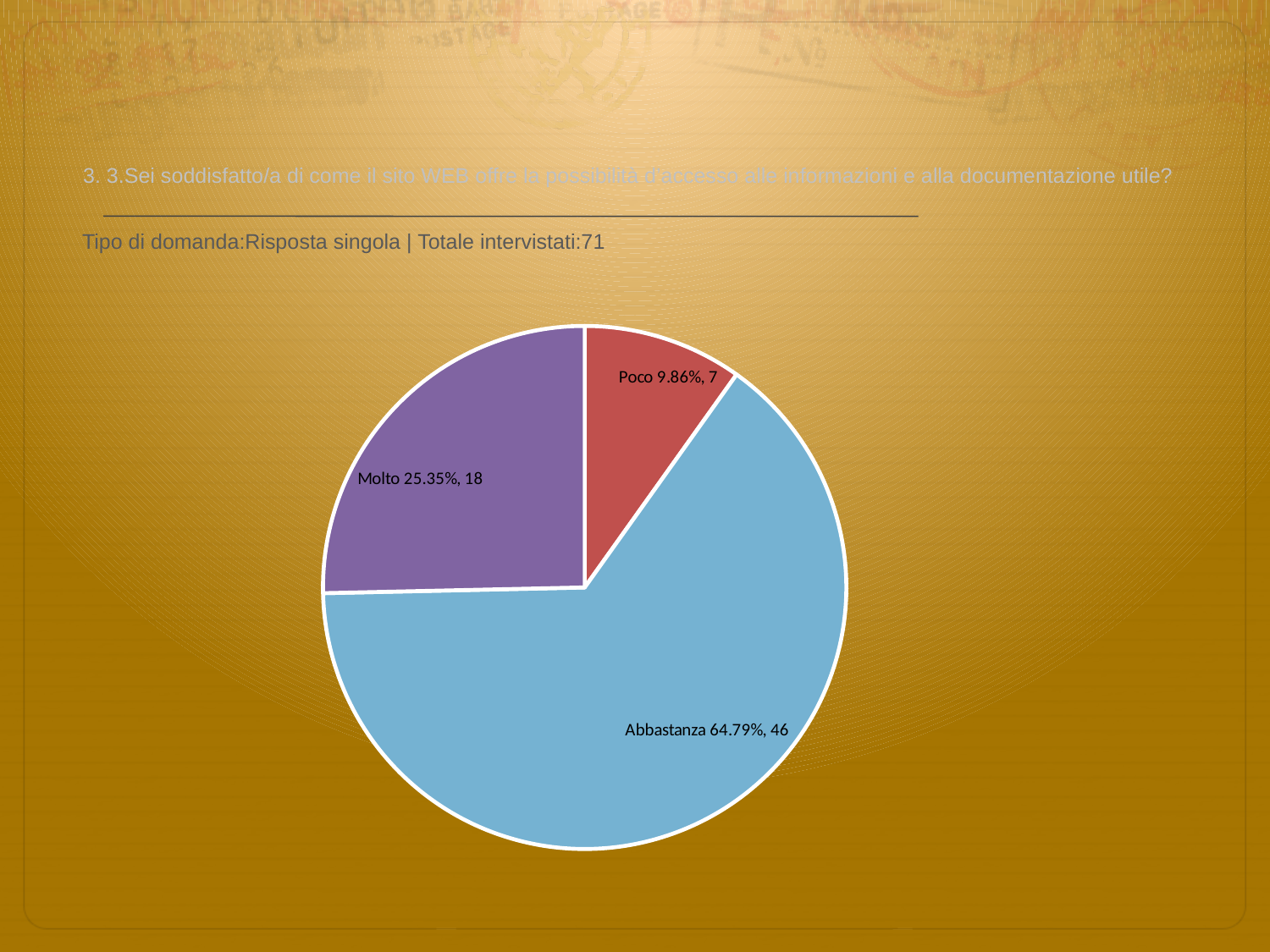
How many respondents answered Molto? 18 What percentage share does the Poco slice have? 9.86% What percentage share does the Abbastanza slice have? 64.79% Which has more respondents, Molto or Poco? Molto How many slices does the pie chart have? 3 What is the difference in respondent count between Abbastanza and Molto? 28 Which category has the largest slice? Abbastanza What kind of chart is shown on the slide? pie chart How many respondents answered Poco? 7 How many respondents answered Abbastanza? 46 Which category has the smallest slice? Poco What percentage share does the Molto slice have? 25.35%